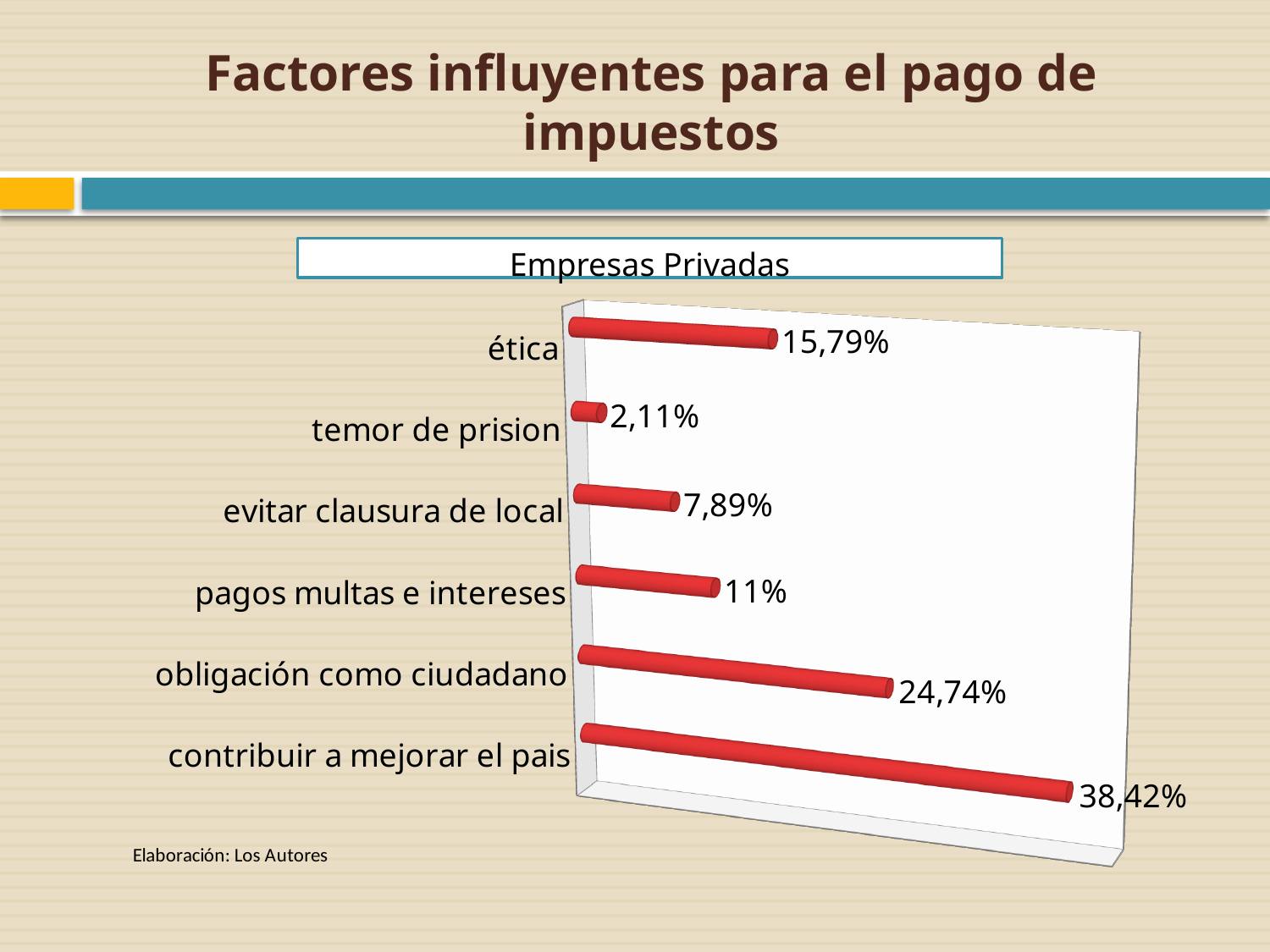
What is the value for "ética"? 15,79% What is the value for "temor de prision"? 2,11% What kind of chart is shown on the slide? bar chart What is the value for "pagos multas e intereses"? 11% Which category has the highest value? contribuir a mejorar el pais What is the difference between "pagos multas e intereses" and "evitar clausura de local"? 3,11% Which category has the lowest value? temor de prision How many categories are shown in the chart? 6 What is the difference between "contribuir a mejorar el pais" and "obligación como ciudadano"? 13,68% Which is larger, the value for "ética" or the value for "evitar clausura de local"? ética What is the title of the chart? Empresas Privadas What is the value for "contribuir a mejorar el pais"? 38,42%